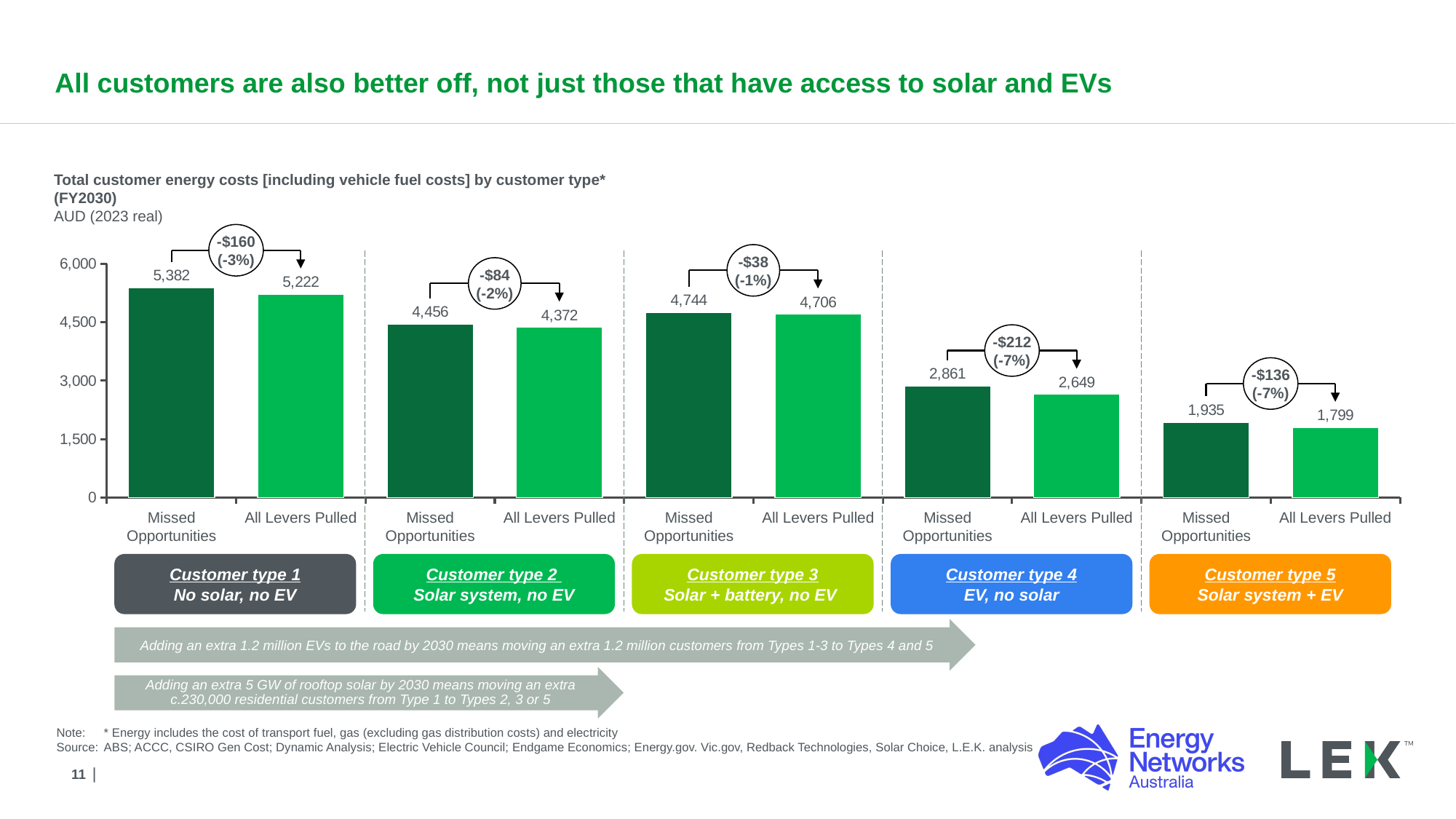
What unit is the chart's data expressed in? AUD (2023 real) Is the All Levers Pulled value for Customer type 5 greater or less than 3,000? less What percentage saving is shown for Customer type 4 (EV, no solar)? -7% What is the value for All Levers Pulled for Customer type 4 (EV, no solar)? 2,649 What is the value for Missed Opportunities for Customer type 1 (No solar, no EV)? 5,382 What is the difference between Missed Opportunities and All Levers Pulled for Customer type 2 (Solar system, no EV)? 84 Which customer type has the highest Missed Opportunities value? Customer type 1 (No solar, no EV) What is the value for All Levers Pulled for Customer type 3 (Solar + battery, no EV)? 4,706 How many customer types are shown on the chart? 5 Which customer type has the lowest All Levers Pulled value? Customer type 5 (Solar system + EV) Which is larger: the Missed Opportunities value for Customer type 4 or the Missed Opportunities value for Customer type 5? Customer type 4 What kind of chart is shown on the slide? Bar chart